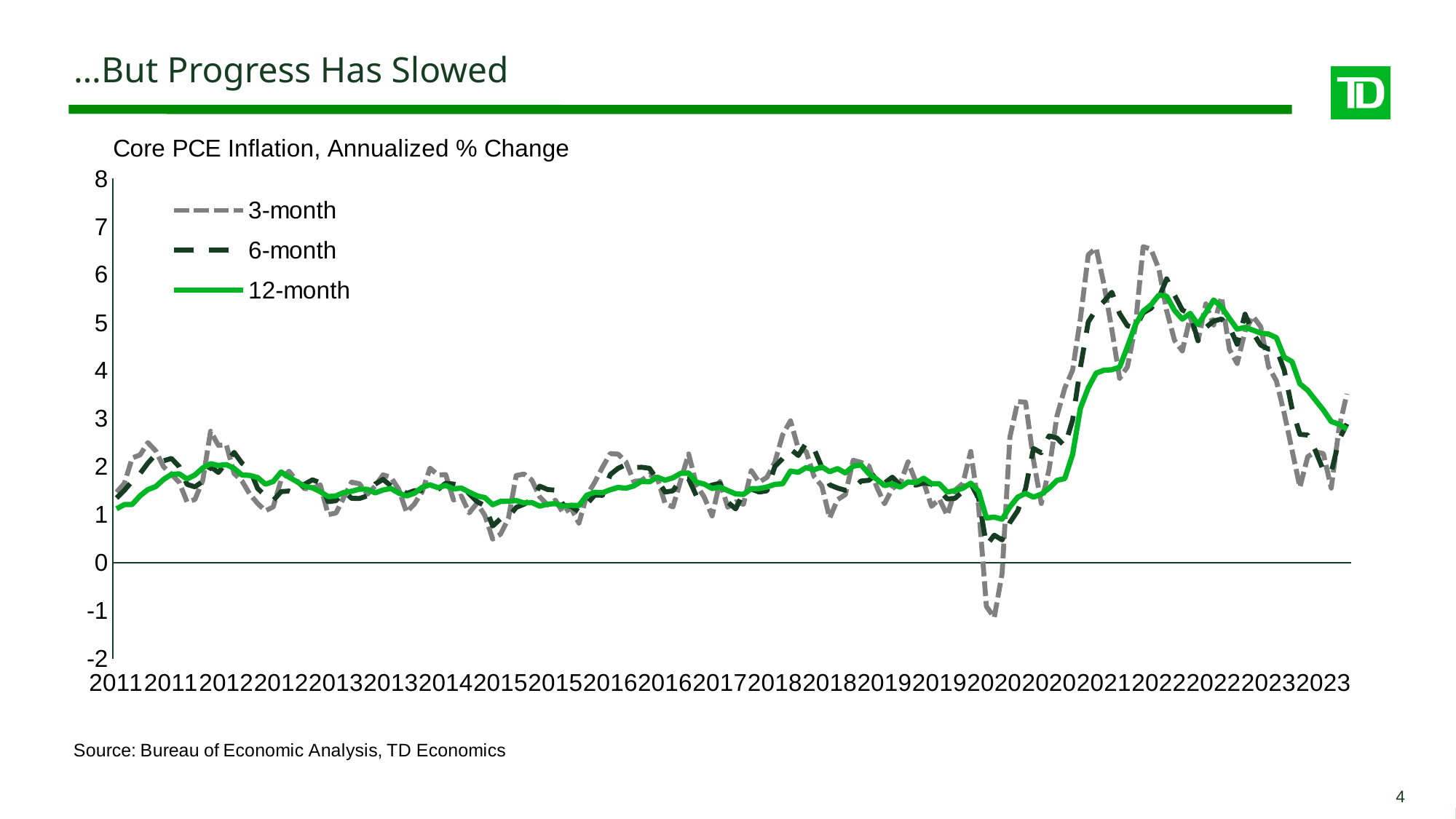
How many series does the legend list? 3 Does the 12-month series rise or fall from its 2022 peak to the end of 2023? fall Which series has the higher peak in 2022, the 3-month or the 12-month? 3-month What kind of chart is shown on the slide? Line chart Is the peak value of the 12-month series in 2022 greater or less than 5? greater What is the title of the chart? Core PCE Inflation, Annualized % Change What is the highest value shown on the y axis? 8 Is the 12-month series value at the start of 2011 greater or less than 2? less Is the lowest value of the 3-month series in 2020 greater or less than 0? less Which series is drawn as a solid green line? 12-month Which series reaches the highest peak on the chart? 3-month Which series falls below 0 in 2020? 3-month